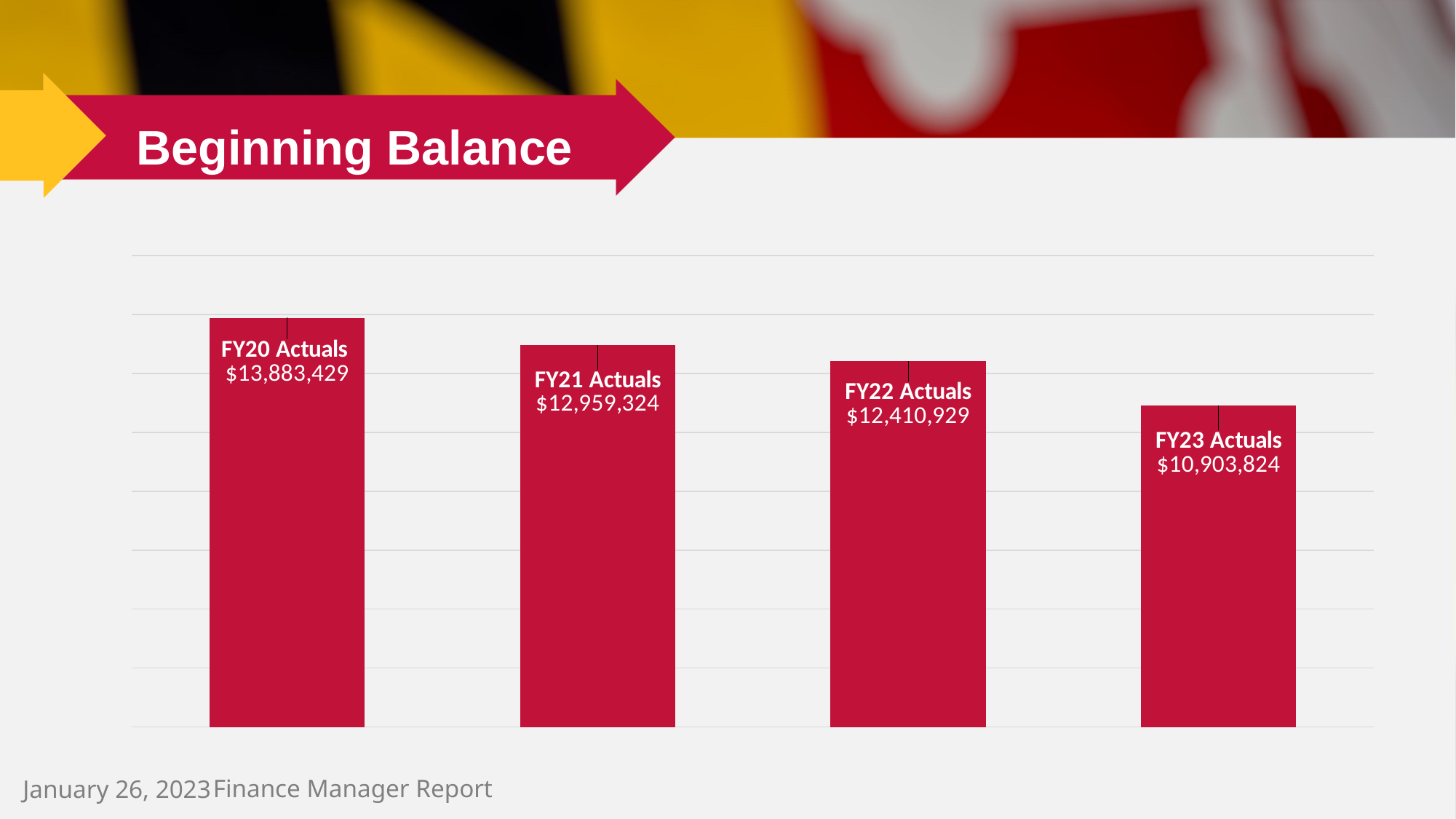
Which category has the highest value? FY20 Actuals What is the value for FY20 Actuals? $13,883,429 What is the value for FY22 Actuals? $12,410,929 Which category has the lowest value? FY23 Actuals What kind of chart is shown on the slide? Bar chart How many bars are shown in the chart? 4 What is the value for FY21 Actuals? $12,959,324 What is the value for FY23 Actuals? $10,903,824 Which is larger, FY21 Actuals or FY22 Actuals? FY21 Actuals Do the values rise or fall from FY20 Actuals to FY23 Actuals? Fall What is the difference between FY20 Actuals and FY21 Actuals? $924,105 What is the difference between FY22 Actuals and FY23 Actuals? $1,507,105